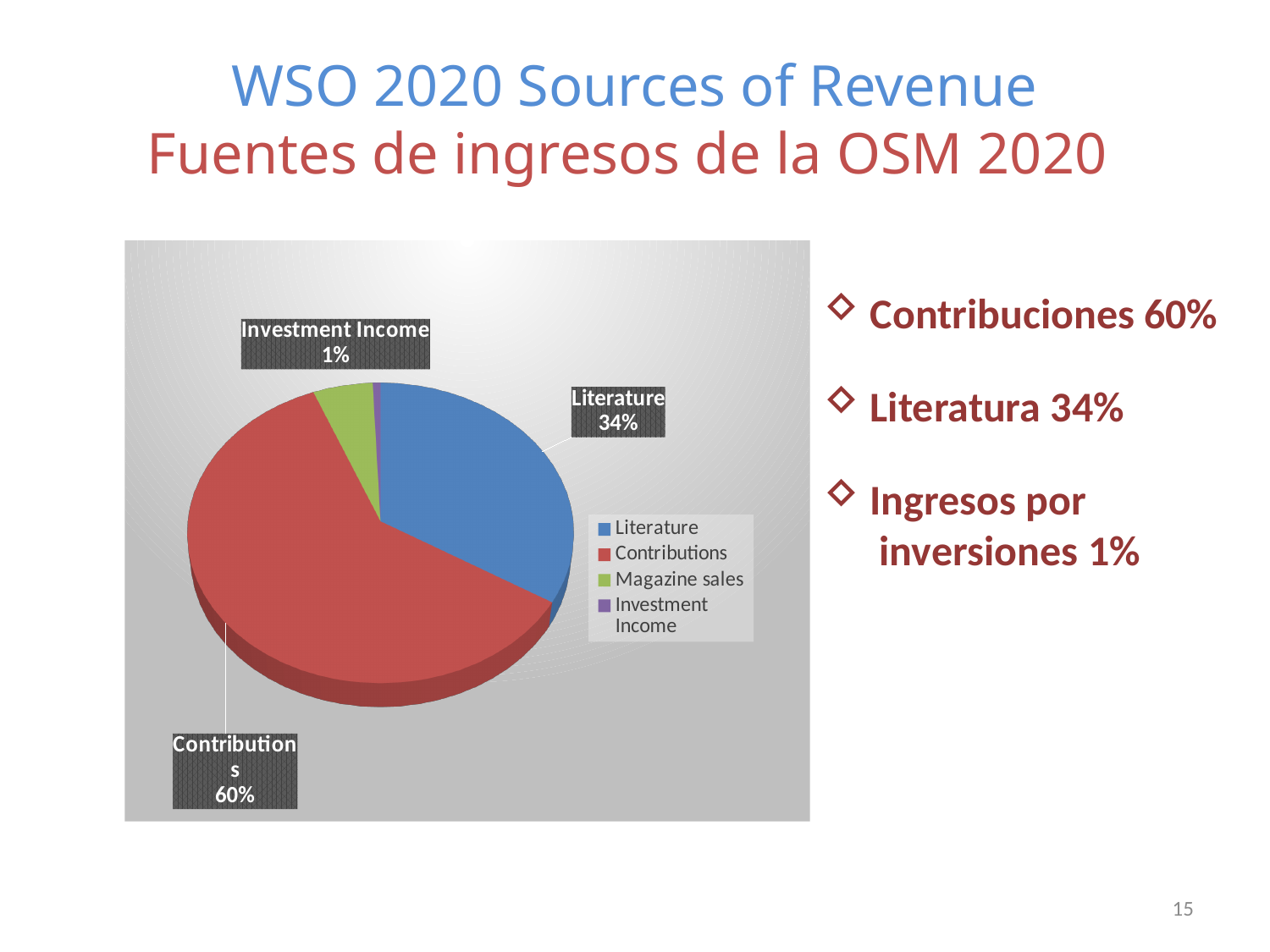
How many categories does the legend of the pie chart list? 4 What percentage is shown for Literature in the pie chart? 34% What percentage is shown for Investment Income in the pie chart? 1% What kind of chart is shown on the slide? Pie chart Which category has the smallest slice of the pie chart? Investment Income Which is larger in the pie chart, Literature or Contributions? Contributions Which is larger in the pie chart, Literature or Investment Income? Literature What share of revenue does the Contributions slice represent in the pie chart? 60% What colour is the Contributions slice in the pie chart? Red Which category has the largest slice of the pie chart? Contributions By how many percentage points does Literature exceed Investment Income in the pie chart? 33 percentage points By how many percentage points does Contributions exceed Literature in the pie chart? 26 percentage points